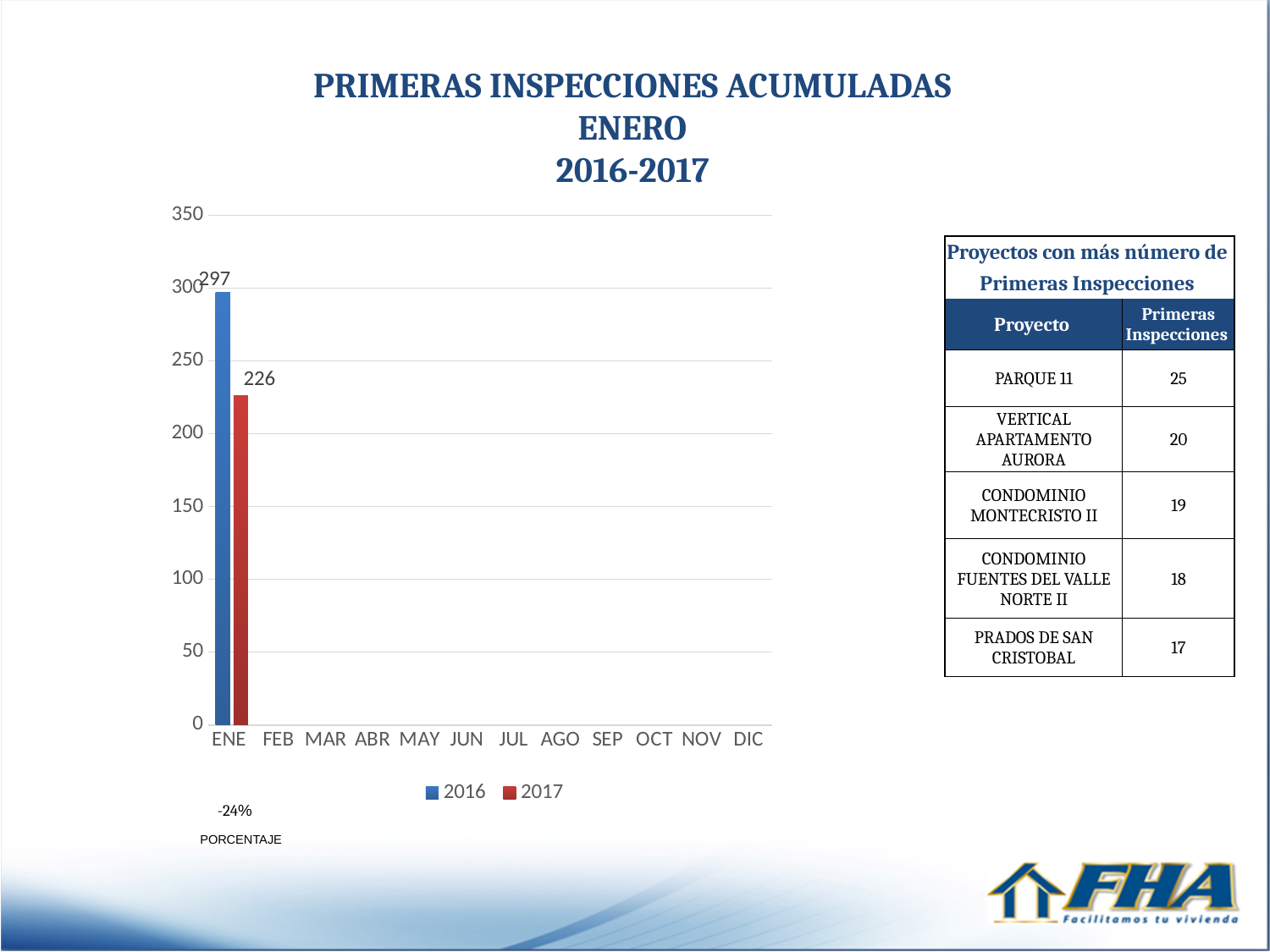
How many series does the legend list? 2 Which series has the higher value in ENE, 2016 or 2017? 2016 What kind of chart is shown on the slide? bar chart Is the value for 2016 in ENE greater or less than 250? greater Is the value for 2017 in ENE greater or less than 250? less What percentage change is shown below the chart? -24% What is the difference between the 2016 and 2017 values in ENE? 71 How many month categories are shown on the x axis? 12 What colour are the bars for the 2017 series? red What is the title of the chart? PRIMERAS INSPECCIONES ACUMULADAS ENERO 2016-2017 What is the value for 2017 in ENE? 226 What is the value for 2016 in ENE? 297